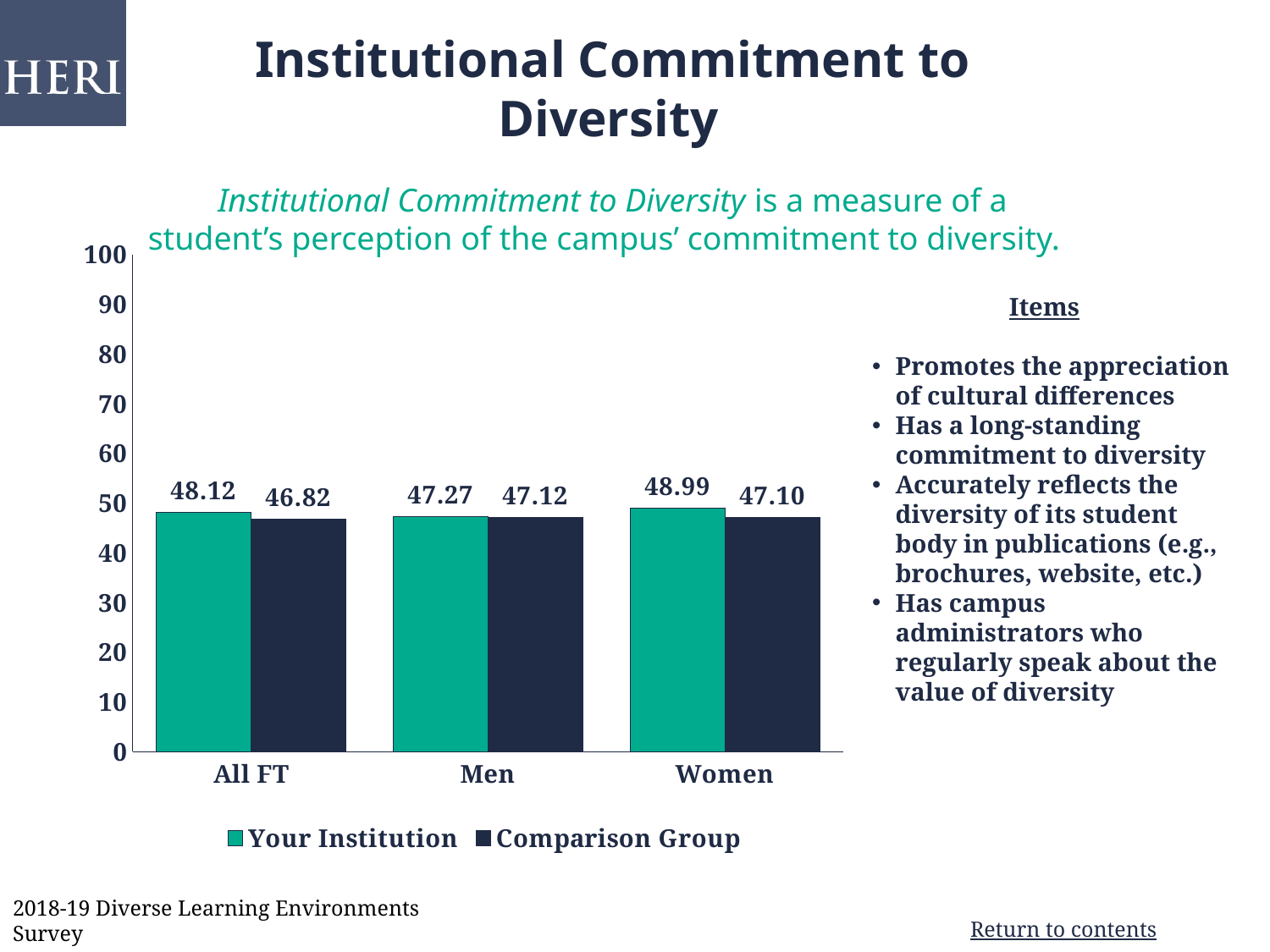
Which category has the lowest value for Your Institution? Men Which category has the highest value for Your Institution? Women What is the value for the Comparison Group in the Women category? 47.10 What is the value for the Comparison Group in the Men category? 47.12 How many series does the legend list? 2 How many categories are shown on the x axis? 3 What is the value for Your Institution in the Men category? 47.27 What kind of chart is shown on the slide? bar chart What is the difference between Your Institution and the Comparison Group in the All FT category? 1.30 Is the value for Your Institution in the Women category greater or less than 50? less What is the value for Your Institution in the All FT category? 48.12 What is the difference between Your Institution and the Comparison Group in the Women category? 1.89